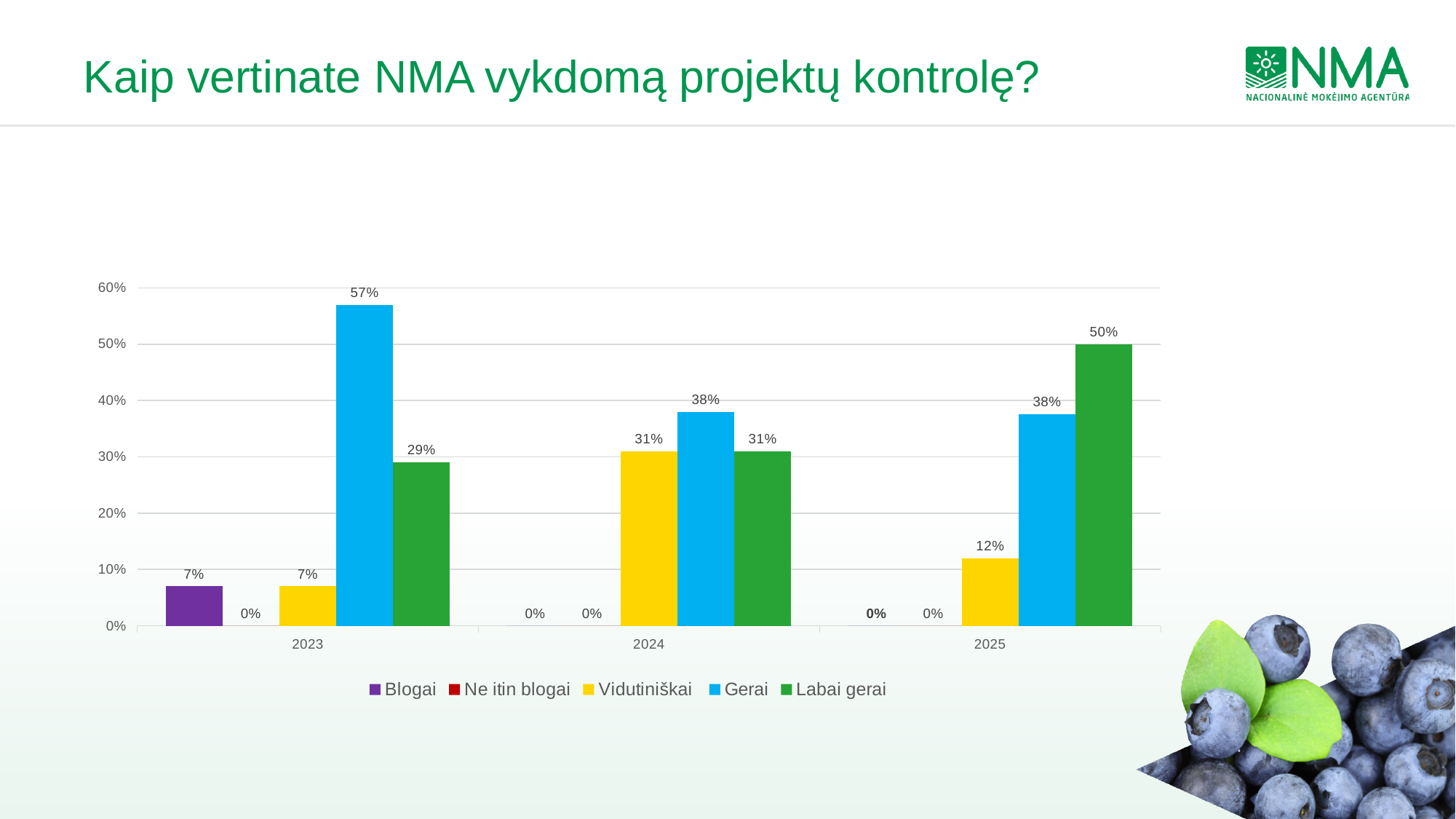
What is the difference between Gerai and Labai gerai in 2023? 28% What is the value for Labai gerai in 2025? 50% Which is larger in 2025: Vidutiniškai or Gerai? Gerai What is the value for Blogai in 2023? 7% How many year categories are shown on the x axis? 3 Does the value for Labai gerai rise or fall from 2023 to 2025? Rise What kind of chart is shown on the slide? Bar chart How many series does the legend list? 5 What is the value for Vidutiniškai in 2024? 31% Which series has the highest value in 2025? Labai gerai What is the value for Gerai in 2023? 57% Which series has the highest value in 2023? Gerai